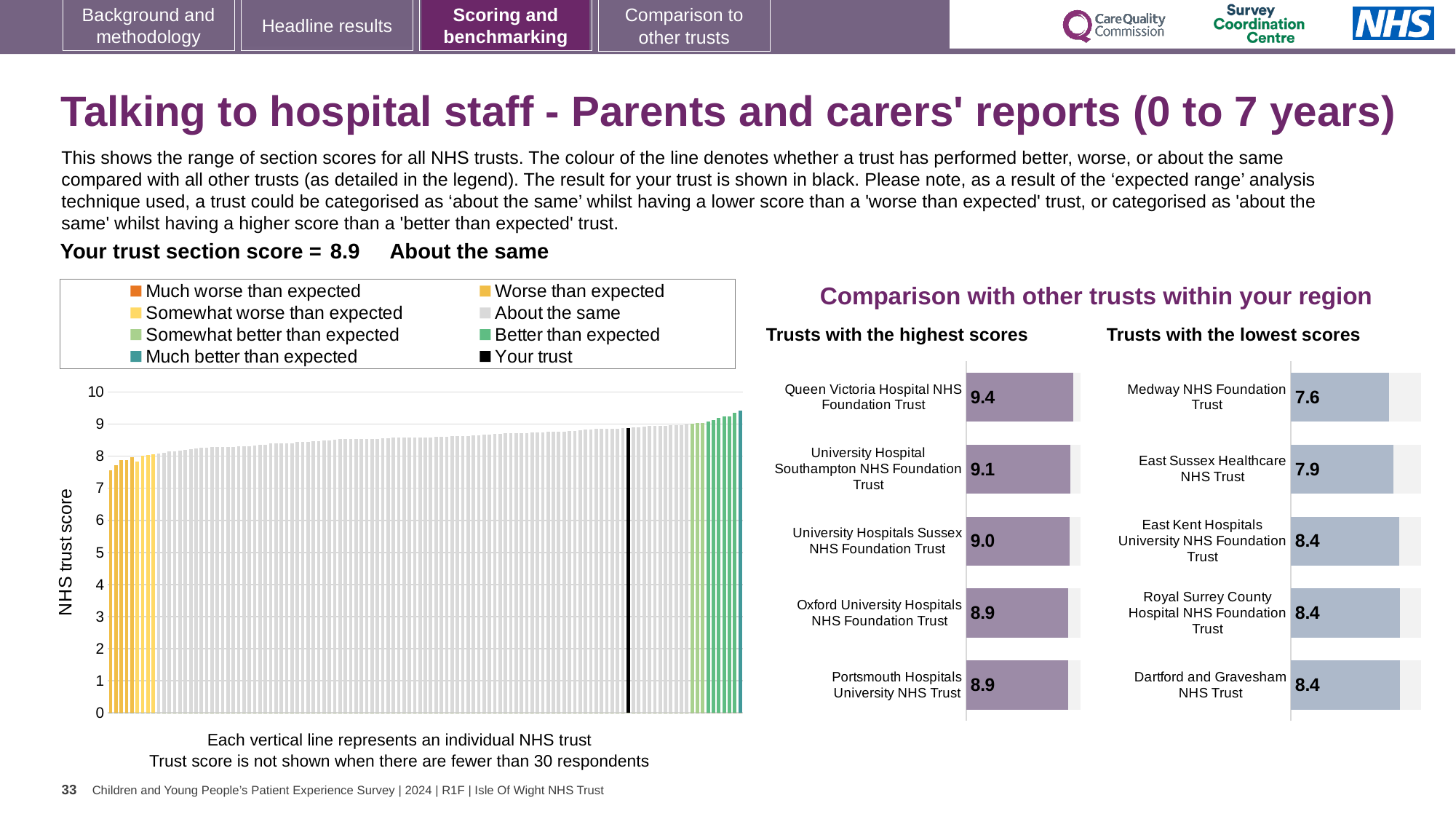
What kind of chart is the large chart on the left with the 'NHS trust score' axis? Bar chart In the large 'NHS trust score' chart on the left, do the bar values rise or fall from left to right? Rise In the 'Trusts with the lowest scores' chart, what is the score for Medway NHS Foundation Trust? 7.6 How many entries does the legend of the large 'NHS trust score' chart on the left list? 8 In the 'Trusts with the highest scores' chart, what is the score for Queen Victoria Hospital NHS Foundation Trust? 9.4 In the 'Trusts with the highest scores' chart, what is the difference between the scores of Queen Victoria Hospital NHS Foundation Trust and University Hospital Southampton NHS Foundation Trust? 0.3 In the 'Trusts with the lowest scores' chart, which has the larger score: East Sussex Healthcare NHS Trust or Medway NHS Foundation Trust? East Sussex Healthcare NHS Trust In the 'Trusts with the highest scores' chart, what is the score for University Hospitals Sussex NHS Foundation Trust? 9.0 In the 'Trusts with the highest scores' chart, which trust has the highest score? Queen Victoria Hospital NHS Foundation Trust In the 'Trusts with the lowest scores' chart, what is the difference between the scores of East Sussex Healthcare NHS Trust and Medway NHS Foundation Trust? 0.3 In the 'Trusts with the lowest scores' chart, which trust has the lowest score? Medway NHS Foundation Trust In the 'Trusts with the highest scores' chart, how many trusts are shown? 5